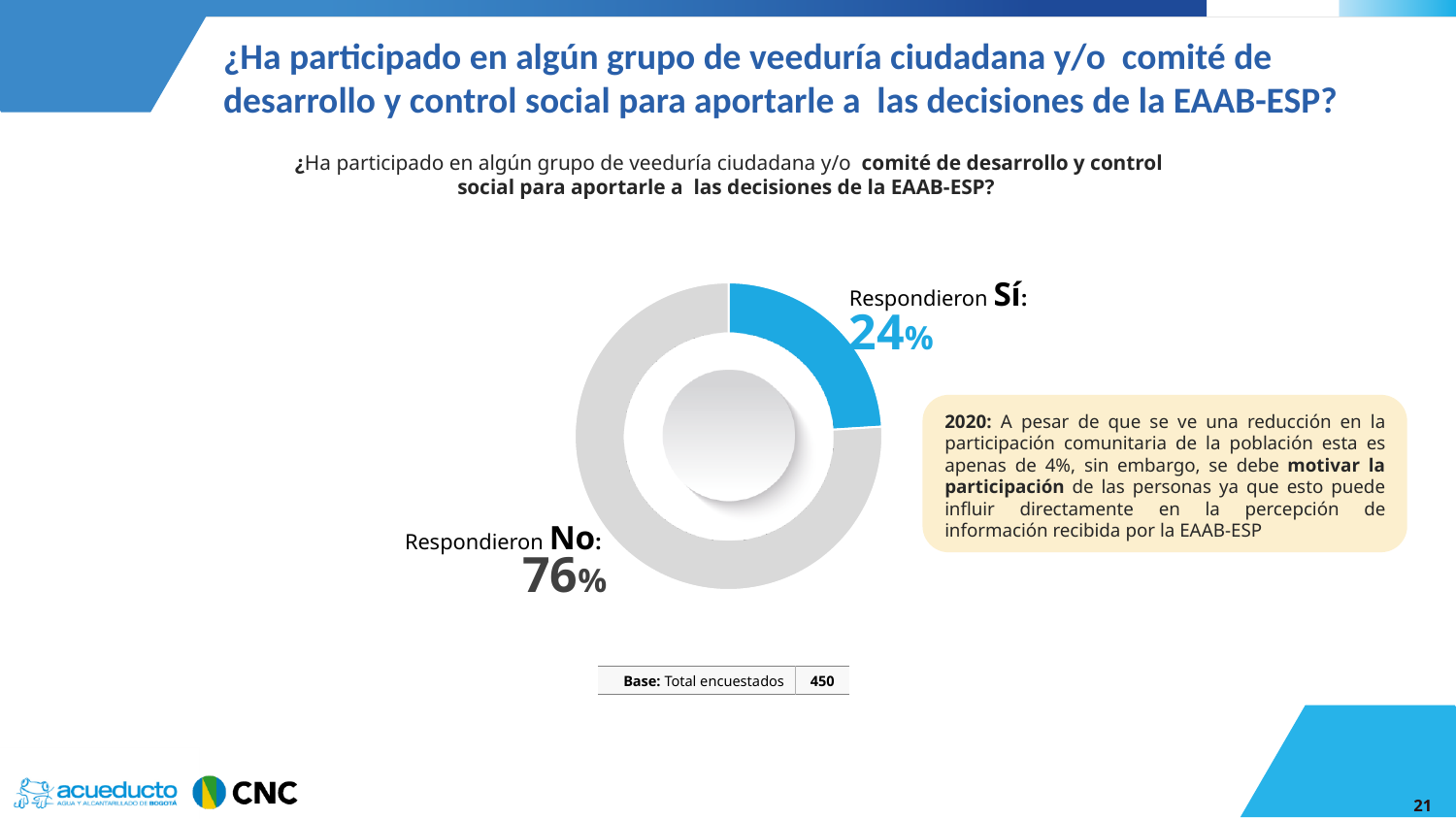
Is the share of respondents who answered "Sí" greater or less than the share who answered "No"? less Which response has the larger share of the chart, "Sí" or "No"? No What is the base (total number of respondents) shown below the chart? 450 What is the total of the two percentages shown in the chart? 100% What colour is the "Sí" slice of the chart? Blue What percentage of respondents answered "Sí"? 24% What kind of chart is shown on the slide? Donut (pie) chart Which response has the smaller share of the chart? Sí What is the difference in percentage points between the "No" and "Sí" responses? 52 What percentage of respondents answered "No"? 76% How many response categories does the chart show? 2